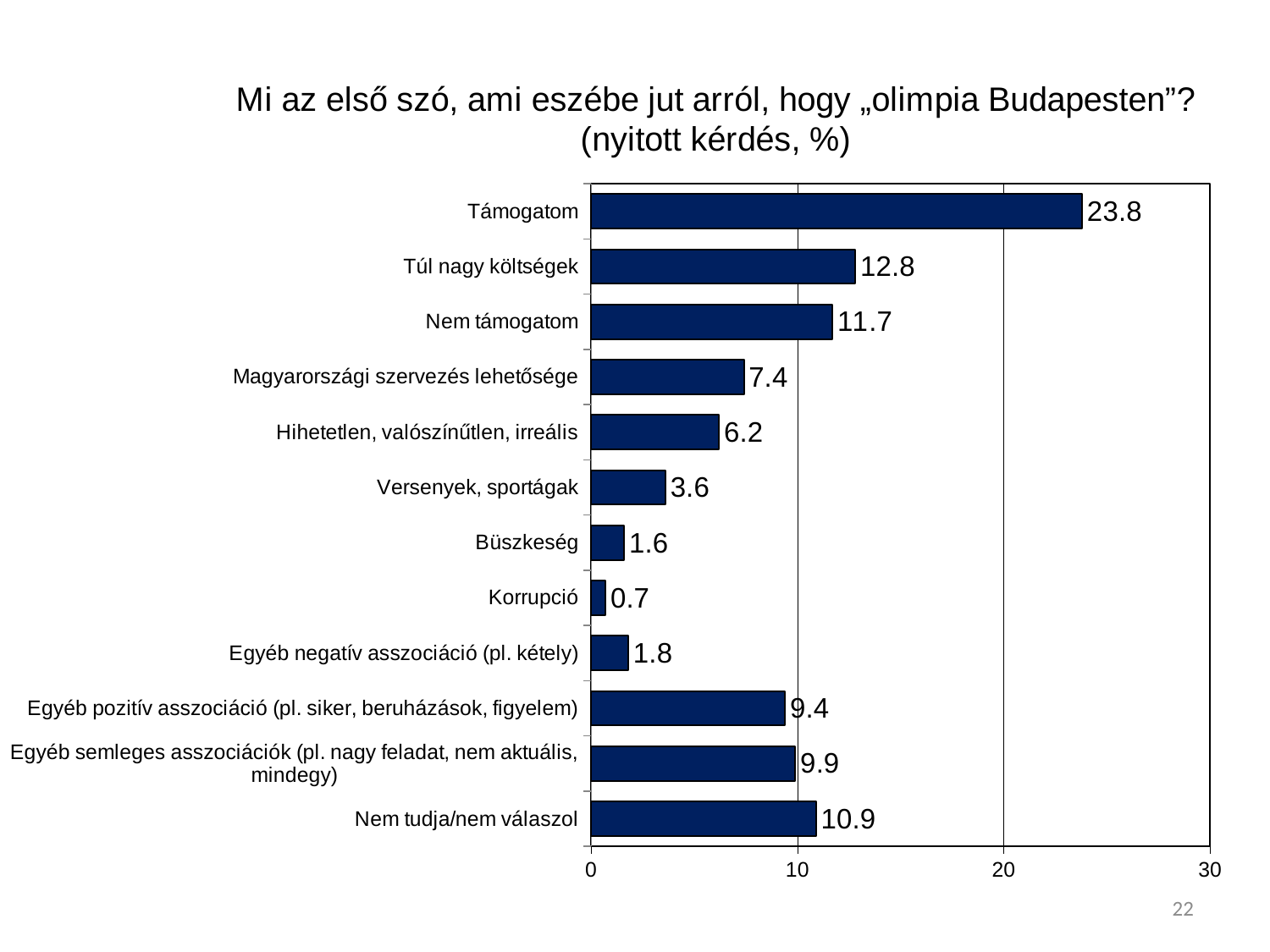
Which category has the highest value? Támogatom What kind of chart is shown on the slide? bar chart What is the value for Versenyek, sportágak? 3.6 What is the value for Nem tudja/nem válaszol? 10.9 How many categories are shown in the chart? 12 Is the value for Hihetetlen, valószínűtlen, irreális greater or less than 10? less What is the value for Korrupció? 0.7 Which is larger, the value for Egyéb pozitív asszociáció (pl. siker, beruházások, figyelem) or the value for Magyarországi szervezés lehetősége? Egyéb pozitív asszociáció (pl. siker, beruházások, figyelem) What is the value for Támogatom? 23.8 What is the difference between the values for Támogatom and Nem támogatom? 12.1 Which category has the lowest value? Korrupció What is the value for Túl nagy költségek? 12.8